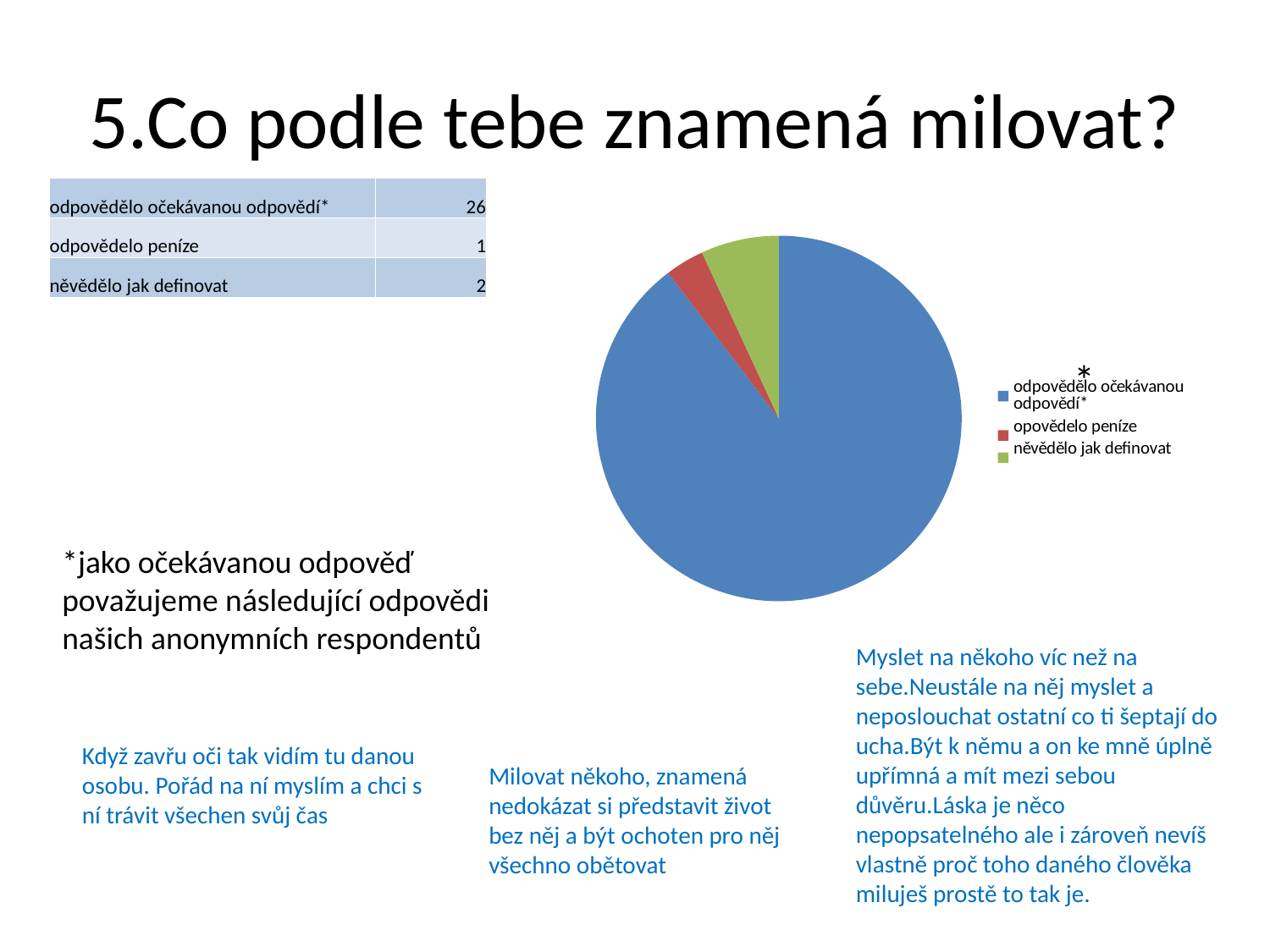
Which category has the largest slice in the pie chart? odpovědělo očekávanou odpovědí* What colour is the largest slice of the pie chart? blue According to the table on the slide, what is the value for 'odpovědelo peníze'? 1 What is the difference between the value for 'odpovědělo očekávanou odpovědí*' and the value for 'něvědělo jak definovat'? 24 How many slices does the pie chart have? 3 Which slice is larger in the pie chart: 'něvědělo jak definovat' or 'opovědelo peníze'? něvědělo jak definovat What kind of chart is shown on the slide? pie chart Which colour represents 'něvědělo jak definovat' in the pie chart legend? green What is the total of all three values shown in the table for the pie chart? 29 Which category has the smallest slice in the pie chart? opovědelo peníze According to the table on the slide, how many respondents answered with the expected answer (odpovědělo očekávanou odpovědí*)? 26 According to the table on the slide, what is the value for 'něvědělo jak definovat'? 2